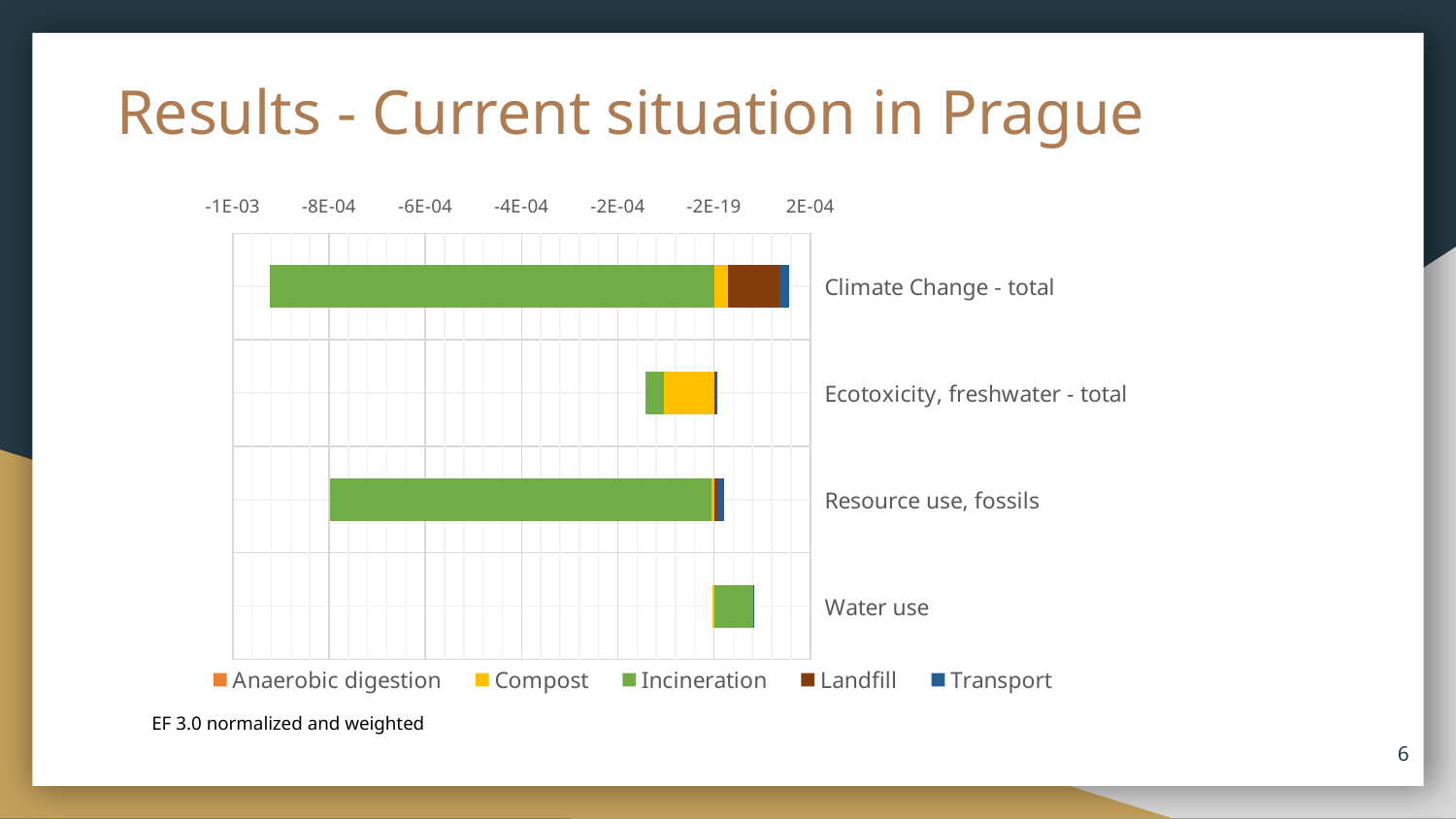
Is the Incineration value for Climate Change - total greater or less than -8E-04? less Is the Incineration value for Water use greater or less than 2E-04? less Which series are listed in the chart legend? Anaerobic digestion, Compost, Incineration, Landfill, Transport What kind of chart is shown on the slide? Stacked bar chart Is the Compost value for Ecotoxicity, freshwater - total greater or less than -2E-04? greater Which category is the only one with a positive Incineration value? Water use What colour represents Incineration in the chart? Green Which category has the most negative Incineration value? Climate Change - total How many categories are plotted on the chart? 4 Which category has the largest Compost segment? Ecotoxicity, freshwater - total How many series does the chart legend list? 5